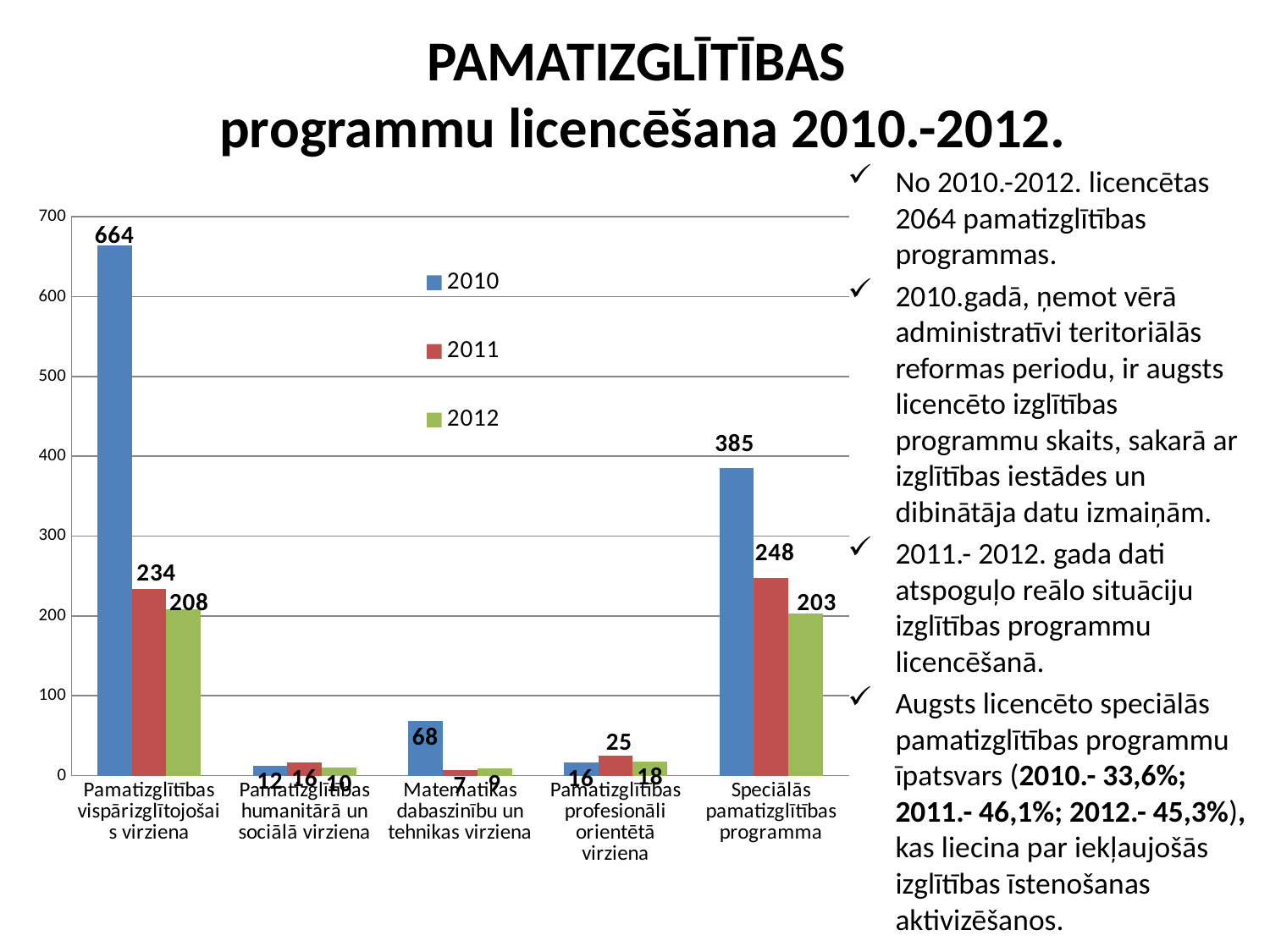
What is the 2010 value for Pamatizglītības vispārizglītojošais virziena? 664 Which category has the lowest 2011 value? Matemātikas dabaszinību un tehnikas virziena What is the 2010 value for Matemātikas dabaszinību un tehnikas virziena? 68 Do the values for Speciālās pamatizglītības programma rise or fall from 2010 to 2012? fall What is the 2011 value for Speciālās pamatizglītības programma? 248 How many categories are shown on the x axis? 5 Which category has the highest 2010 value? Pamatizglītības vispārizglītojošais virziena What is the difference between the 2010 and 2011 values for Speciālās pamatizglītības programma? 137 Which is larger for Pamatizglītības profesionāli orientētā virziena: the 2011 value or the 2012 value? 2011 What is the 2012 value for Pamatizglītības vispārizglītojošais virziena? 208 What type of chart is shown on the slide? bar chart How many series does the legend list? 3